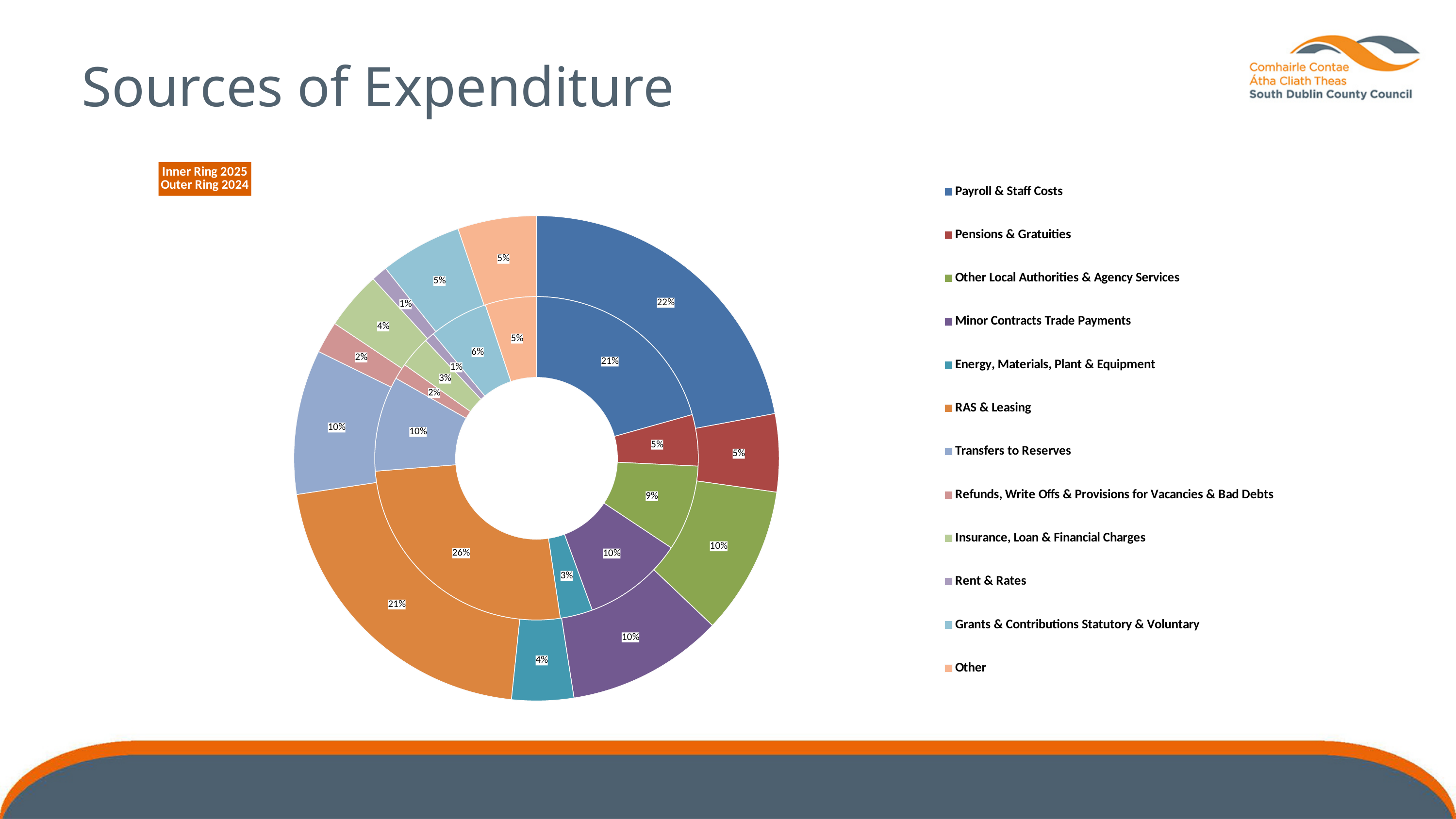
Which category has the largest share in the inner ring (2025)? RAS & Leasing How many categories does the legend list? 12 By how many percentage points did the RAS & Leasing share change from the outer ring (2024) to the inner ring (2025)? 5 percentage points What share of expenditure is Energy, Materials, Plant & Equipment in the inner ring (2025)? 3% What share of expenditure is RAS & Leasing in the inner ring (2025)? 26% What kind of chart is shown on the slide? Doughnut chart Which category has the largest share in the outer ring (2024)? Payroll & Staff Costs What is the title of the chart on the slide? Inner Ring 2025 Outer Ring 2024 Which year does the inner ring of the chart represent? 2025 In the inner ring (2025), which is larger: Grants & Contributions Statutory & Voluntary or Insurance, Loan & Financial Charges? Grants & Contributions Statutory & Voluntary Which category has the smallest share in the outer ring (2024)? Rent & Rates What share of expenditure is Payroll & Staff Costs in the outer ring (2024)? 22%